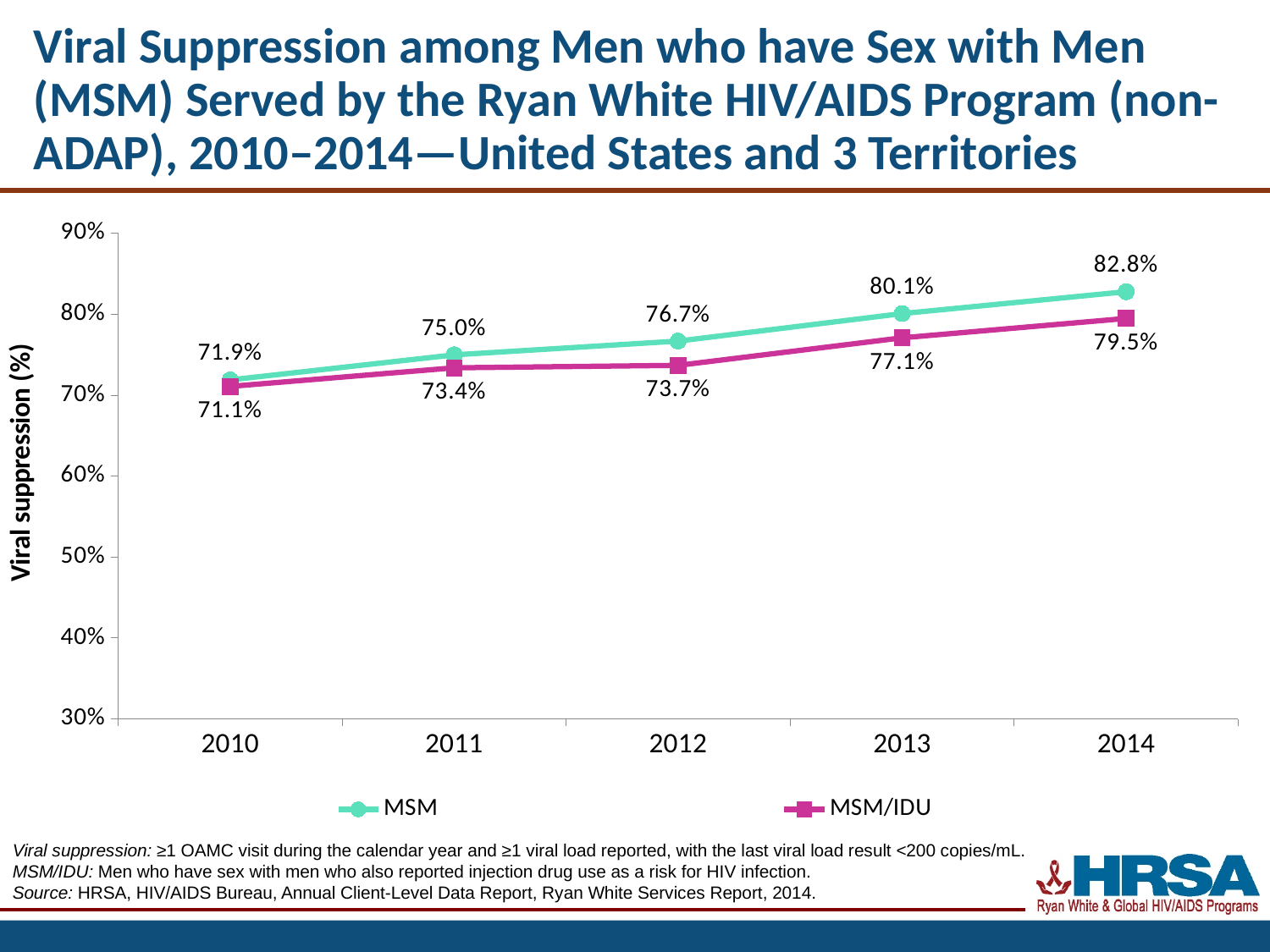
What kind of chart is shown on the slide? Line chart What is the difference in percentage points between MSM and MSM/IDU viral suppression in 2014? 3.3 percentage points How many series does the legend list? 2 Which group had higher viral suppression in 2011, MSM or MSM/IDU? MSM What was the viral suppression percentage for MSM/IDU in 2010? 71.1% In which year was viral suppression for MSM/IDU lowest? 2010 What was the viral suppression percentage for MSM in 2014? 82.8% What was the viral suppression percentage for MSM in 2012? 76.7% What was the viral suppression percentage for MSM/IDU in 2013? 77.1% In which year was viral suppression for MSM highest? 2014 How many years are shown on the x axis? 5 Does viral suppression for MSM/IDU rise or fall from 2010 to 2014? Rise